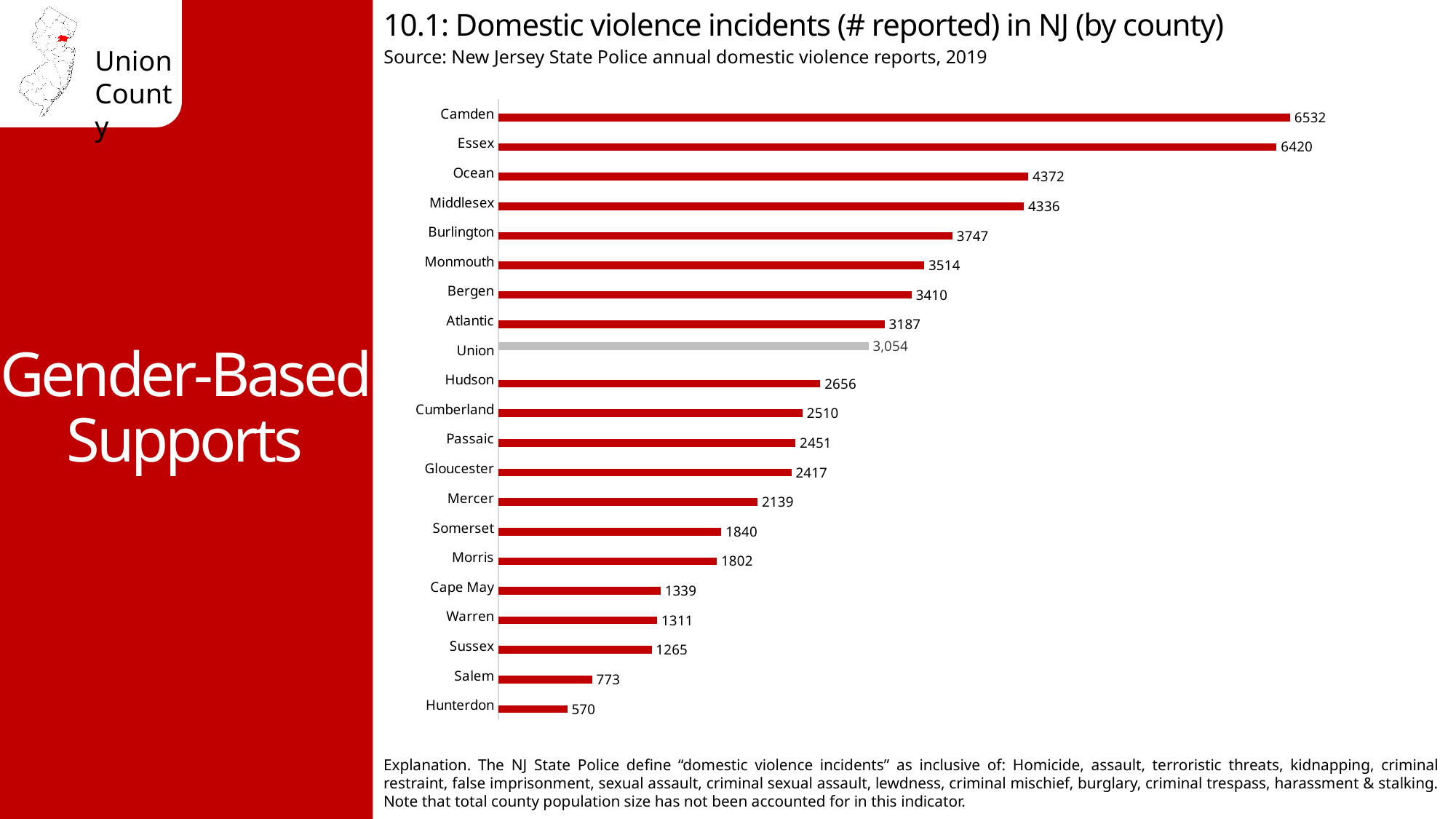
What is the difference in reported incidents between Camden and Essex? 112 Which county has more reported incidents, Somerset or Morris? Somerset How many counties are shown in the chart? 21 What is the number of reported domestic violence incidents for Hunterdon county? 570 Which county has more reported incidents, Ocean or Middlesex? Ocean What is the number of reported domestic violence incidents for Camden county? 6532 What is the number of reported domestic violence incidents for Union county? 3,054 What is the difference in reported incidents between Atlantic and Union? 133 Which county has the highest number of reported domestic violence incidents? Camden Which county has the lowest number of reported domestic violence incidents? Hunterdon Which county's bar is shown in grey rather than red? Union What type of chart is used to show domestic violence incidents by county? Bar chart